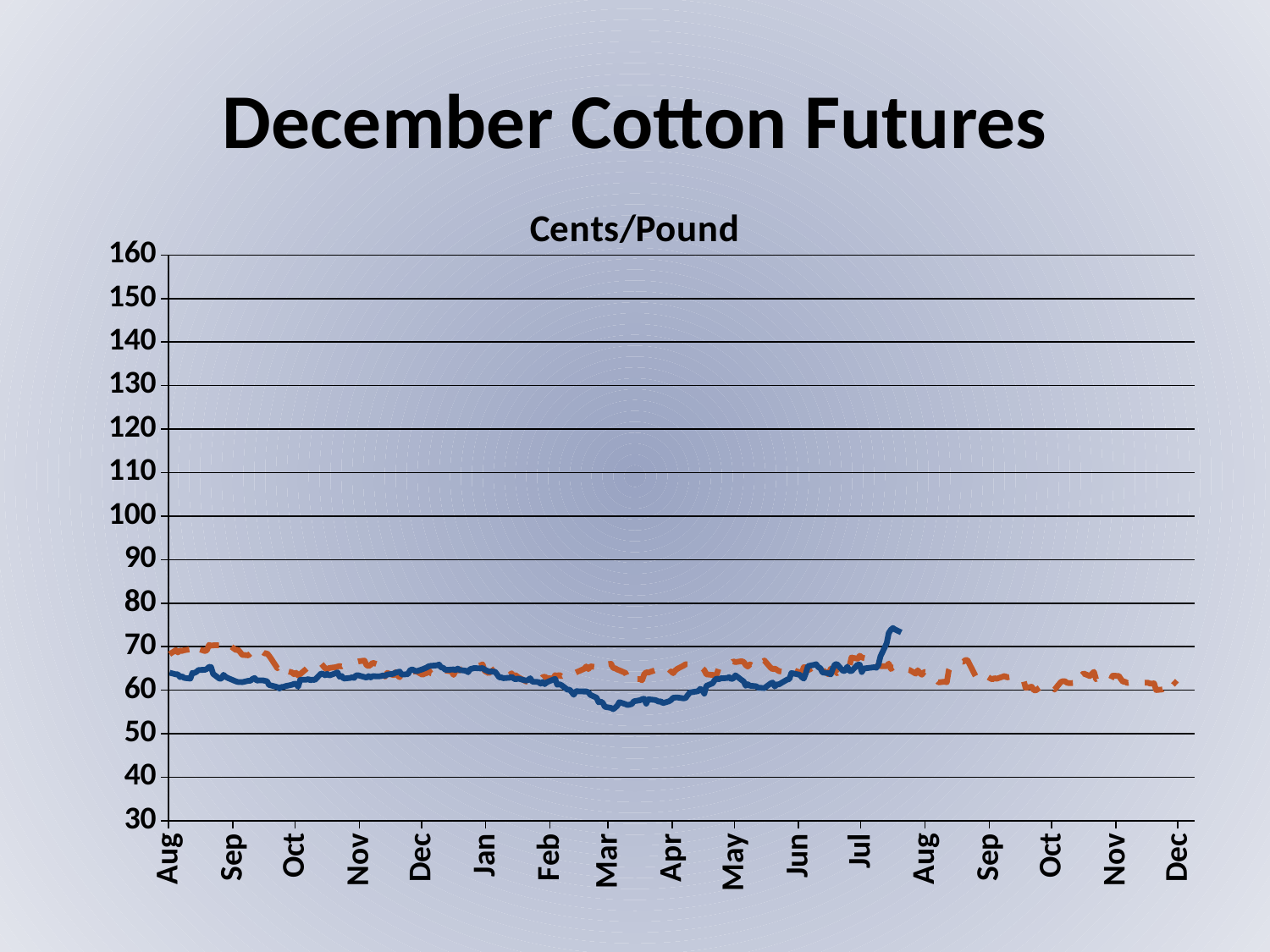
Which line is higher at Mar, the solid blue line or the dashed orange line? the dashed orange line What is the title shown above the chart's plot area? Cents/Pound Does either line ever rise above 80 on the chart? No How many month labels are shown along the x axis? 17 What is the highest value shown on the y axis? 160 Is the value of the dashed orange line at Dec (right end) greater or less than 70? less What kind of chart is shown on the slide? line chart Does the solid blue line rise or fall between Feb and Mar? fall Is the peak of the solid blue line just after Jul greater or less than 70? greater Does the dashed orange line rise or fall overall from the second Sep to Dec? fall How many lines are plotted on the chart? 2